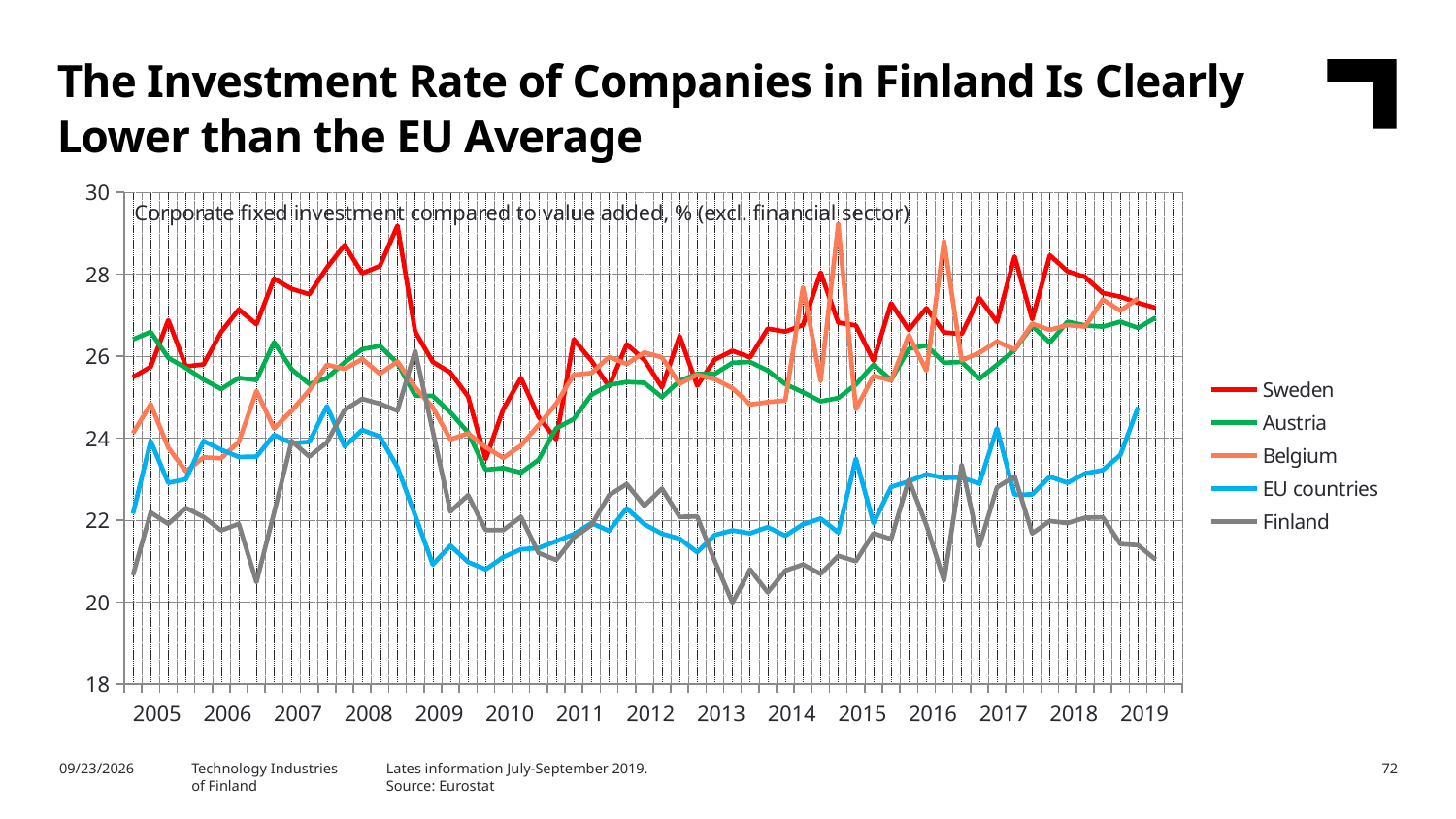
Which series is the lowest at the end of the chart in 2019? Finland How many series does the legend list? 5 Which is higher at the end of 2019, EU countries or Finland? EU countries Which countries or groups are listed in the legend? Sweden, Austria, Belgium, EU countries, Finland Is the value for Sweden at the start of 2005 greater or less than 24? greater What kind of chart is shown on the slide? line chart How many years are labelled on the x axis? 15 Is the value for Finland at the end of 2019 greater or less than 22? less What is the subtitle printed inside the chart area? Corporate fixed investment compared to value added, % (excl. financial sector) Is the peak value for Sweden in 2008 greater or less than 28? greater Which is higher at the end of 2019, Sweden or Finland? Sweden